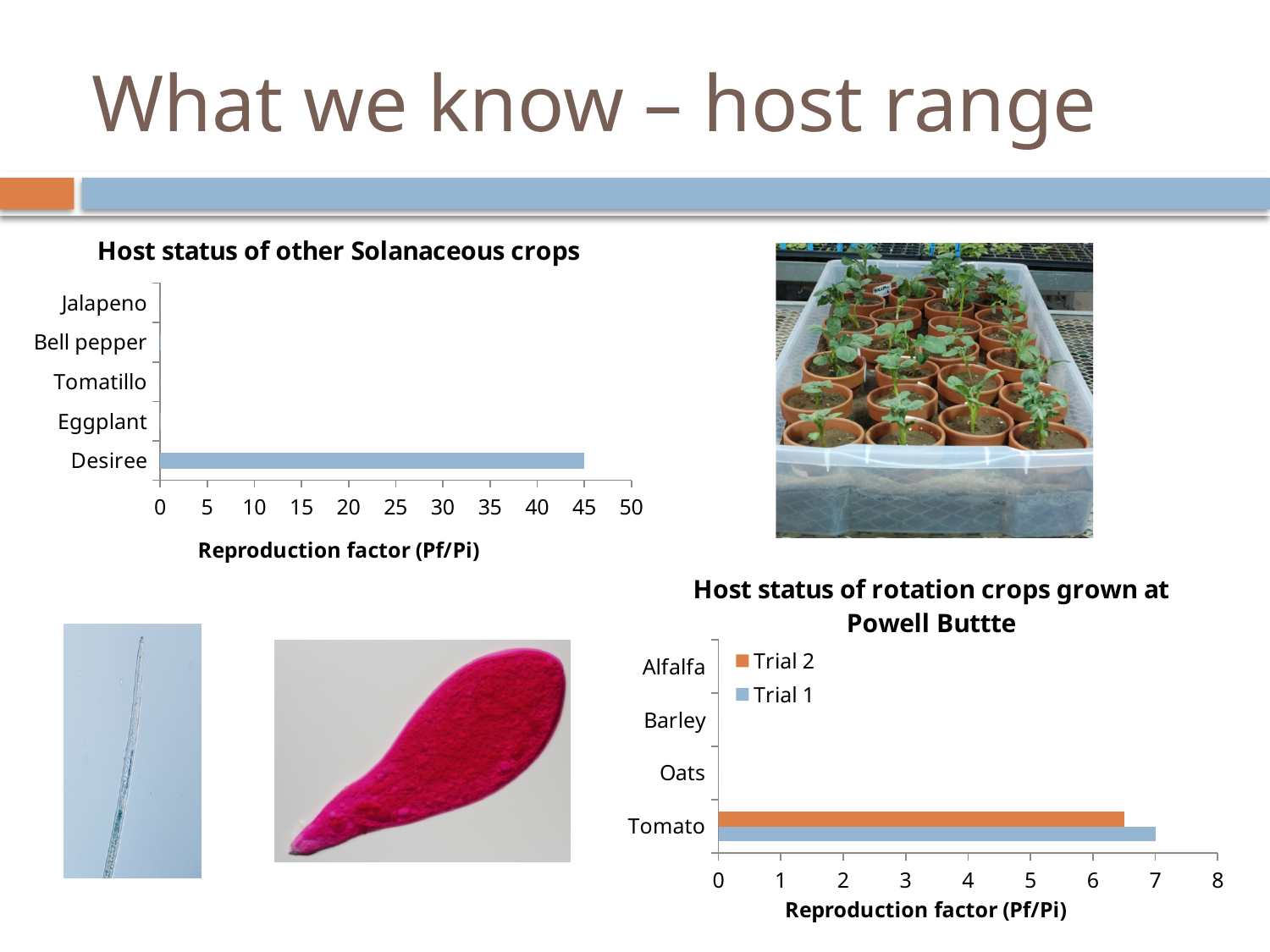
In the chart titled 'Host status of other Solanaceous crops', is the value for Desiree greater or less than 40? greater How many crops are listed on the y axis of the chart titled 'Host status of other Solanaceous crops'? 5 How many crops are listed on the y axis of the chart titled 'Host status of rotation crops grown at Powell Buttte'? 4 In the chart titled 'Host status of other Solanaceous crops', what is the reproduction factor for Desiree? 45 In the chart titled 'Host status of rotation crops grown at Powell Buttte', what is the Trial 1 reproduction factor for Tomato? 7 How many series does the legend list in the chart titled 'Host status of rotation crops grown at Powell Buttte'? 2 What kind of chart is 'Host status of other Solanaceous crops'? Bar chart In the chart titled 'Host status of rotation crops grown at Powell Buttte', which is larger for Tomato, Trial 1 or Trial 2? Trial 1 What is the x-axis title of the chart titled 'Host status of other Solanaceous crops'? Reproduction factor (Pf/Pi) In the chart titled 'Host status of other Solanaceous crops', which crop has the highest reproduction factor? Desiree In the chart titled 'Host status of rotation crops grown at Powell Buttte', is the Trial 2 value for Tomato greater or less than 6? greater In the chart titled 'Host status of rotation crops grown at Powell Buttte', which series is shown in orange? Trial 2